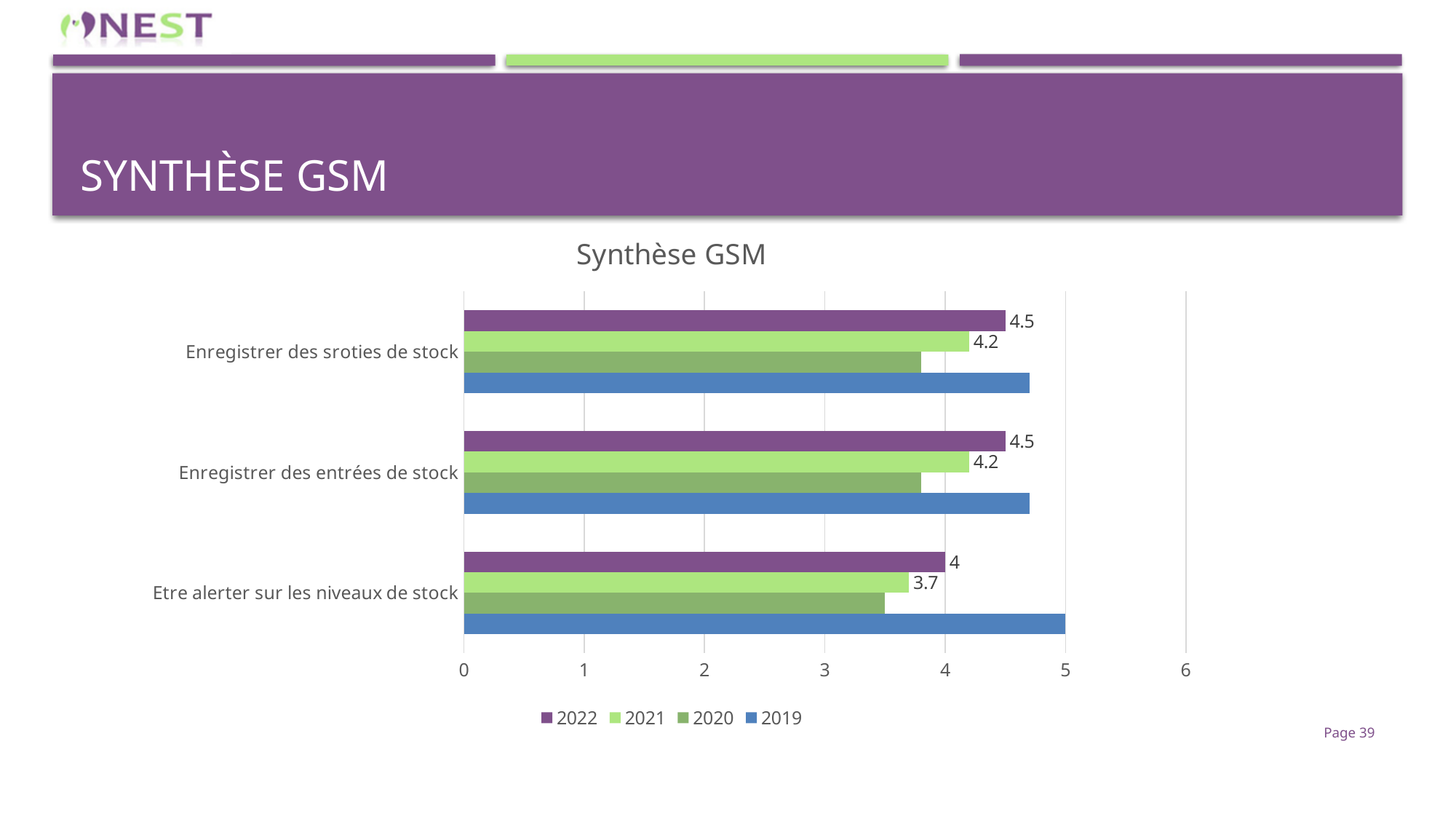
What is the value for 2021 for "Etre alerter sur les niveaux de stock"? 3.7 How many categories are shown on the chart? 3 Is the 2019 value for "Enregistrer des sroties de stock" greater or less than 4? greater What is the value for 2022 for "Etre alerter sur les niveaux de stock"? 4 What is the difference between the 2022 and 2021 values for "Enregistrer des sroties de stock"? 0.3 For 2021, which is larger: "Enregistrer des entrées de stock" or "Etre alerter sur les niveaux de stock"? Enregistrer des entrées de stock How many series does the legend list? 4 What kind of chart is shown on the slide? bar chart Is the 2020 value for "Etre alerter sur les niveaux de stock" greater or less than 4? less Which category has the lowest value for 2022? Etre alerter sur les niveaux de stock What is the value for 2022 for "Enregistrer des entrées de stock"? 4.5 What is the difference between the 2022 values for "Enregistrer des entrées de stock" and "Etre alerter sur les niveaux de stock"? 0.5